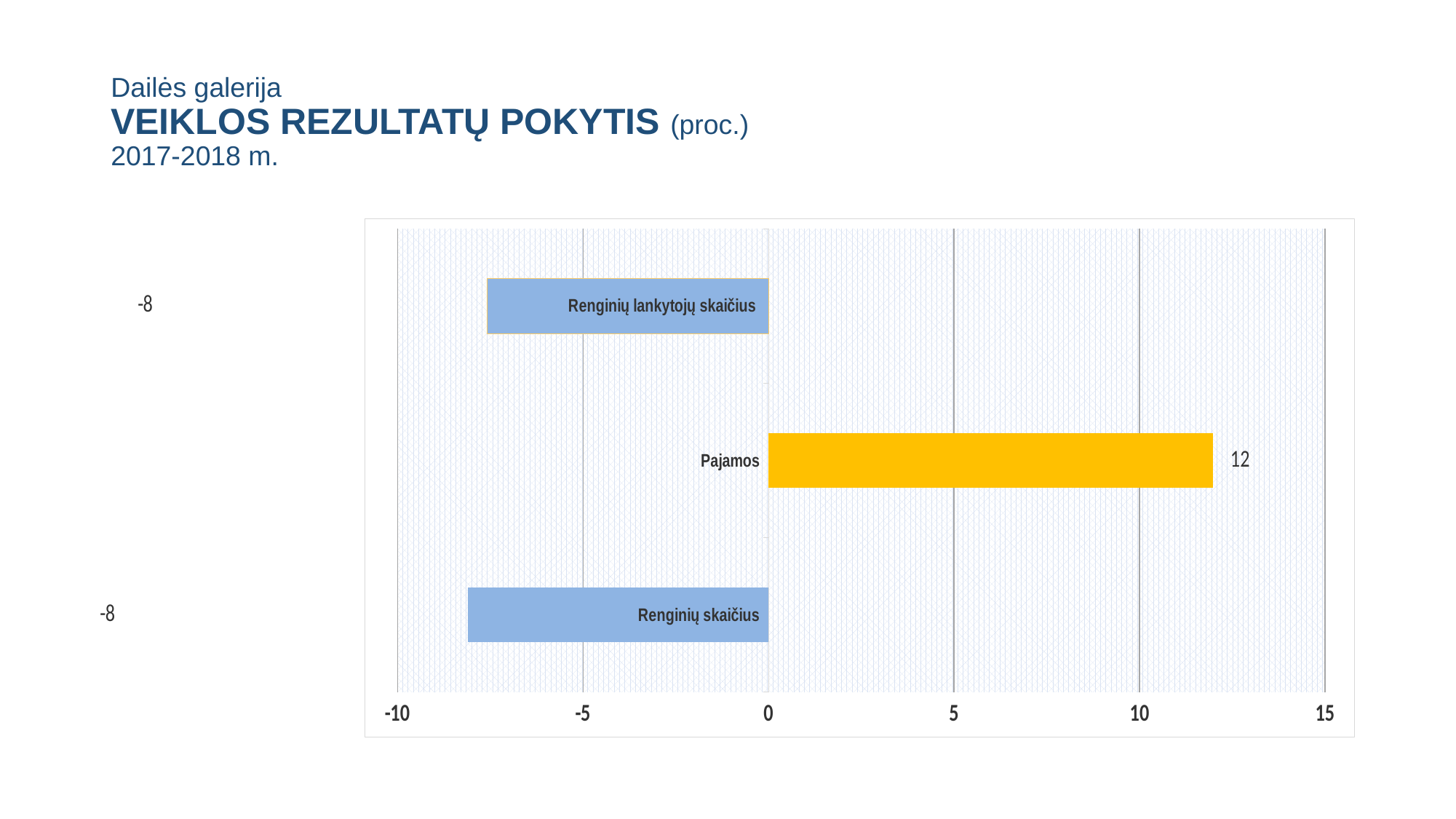
How many categories are plotted in the chart? 3 Is the value for Renginių skaičius greater or less than -5? less What is the difference between the value for Pajamos and the value for Renginių skaičius? 20 What kind of chart is shown on the slide? bar chart What is the value for Renginių lankytojų skaičius? -8 What is the value for Renginių skaičius? -8 Which category has the highest value? Pajamos Which is larger, the value for Pajamos or the value for Renginių skaičius? Pajamos What colour is the bar for Pajamos? yellow What is the title of the chart on the slide? VEIKLOS REZULTATŲ POKYTIS (proc.) Is the value for Pajamos greater or less than 10? greater What is the value for Pajamos? 12